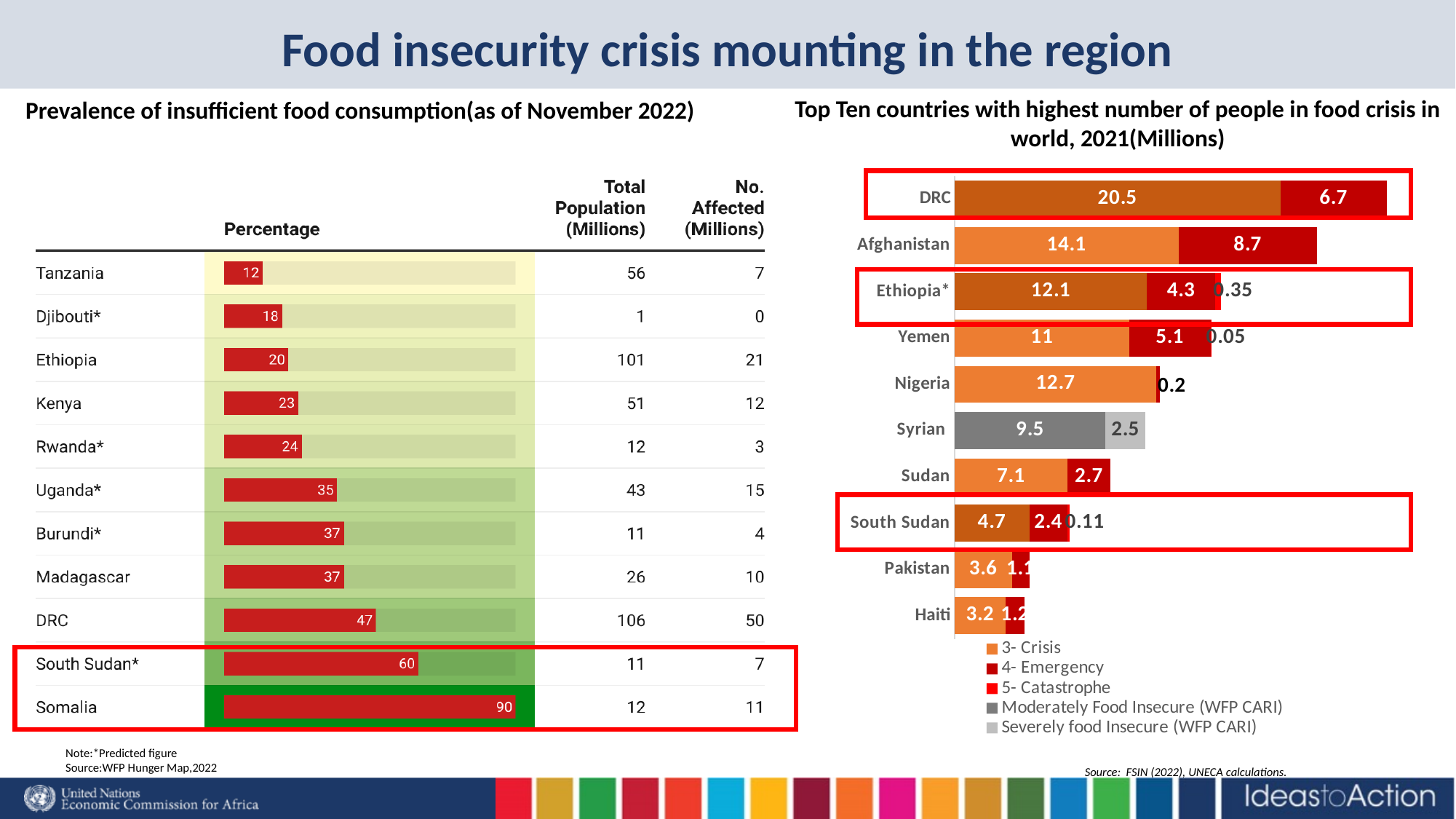
In the 'Top Ten countries with highest number of people in food crisis' chart, what is the total of the stacked bar for DRC? 27.2 How many countries are shown in the 'Top Ten countries with highest number of people in food crisis' chart? 10 In the 'Prevalence of insufficient food consumption' chart, what is the number affected (millions) for DRC? 50 In the 'Top Ten countries with highest number of people in food crisis' chart, what is the 4-Emergency value for Afghanistan? 8.7 In the 'Prevalence of insufficient food consumption' chart, which country has the highest percentage? Somalia In the 'Top Ten countries with highest number of people in food crisis' chart, what is the 3-Crisis value for DRC? 20.5 In the 'Top Ten countries with highest number of people in food crisis' chart, which country has the largest 3-Crisis value? DRC In the 'Top Ten countries with highest number of people in food crisis' chart, what is the total of the stacked bar for Sudan? 9.8 In the 'Prevalence of insufficient food consumption' chart, what is the difference in percentage between Somalia and South Sudan? 30 In the 'Prevalence of insufficient food consumption' chart, which country has the lowest percentage? Tanzania What kind of chart is the 'Top Ten countries with highest number of people in food crisis' chart? Stacked bar chart How many series does the legend of the 'Top Ten countries with highest number of people in food crisis' chart list? 5